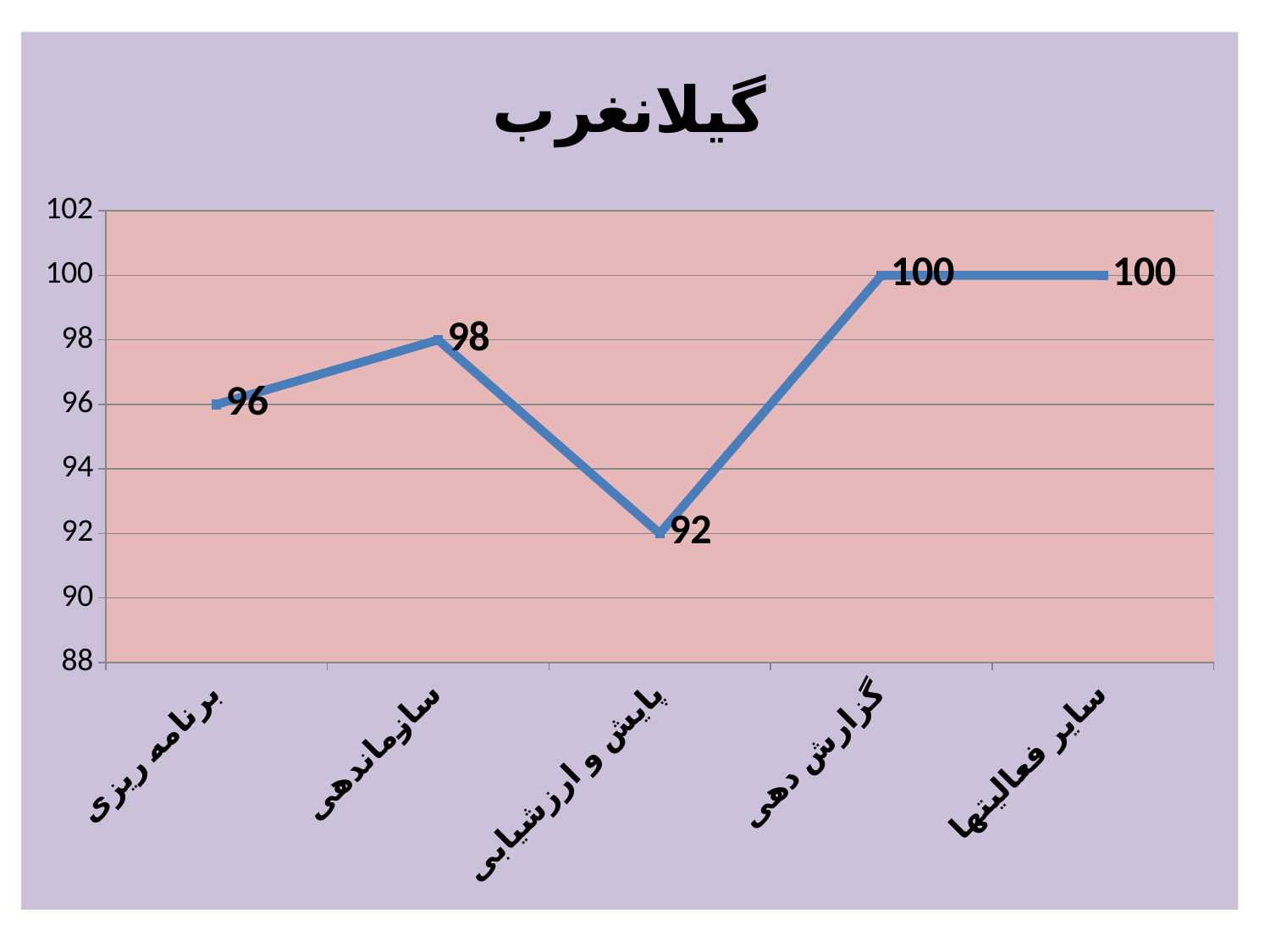
What kind of chart is shown on the slide? line chart What is the value for پایش و ارزشیابی? 92 What is the value for برنامه ریزی? 96 How many categories are shown on the x axis? 5 What is the difference between the values for سازماندهی and پایش و ارزشیابی? 6 What is the value for گزارش دهی? 100 What is the value for سازماندهی? 98 What is the difference between the values for گزارش دهی and برنامه ریزی? 4 Which is larger, the value for سازماندهی or the value for برنامه ریزی? سازماندهی Which category has the lowest value? پایش و ارزشیابی What is the title of the chart? گیلانغرب Is the value for پایش و ارزشیابی greater or less than 94? less